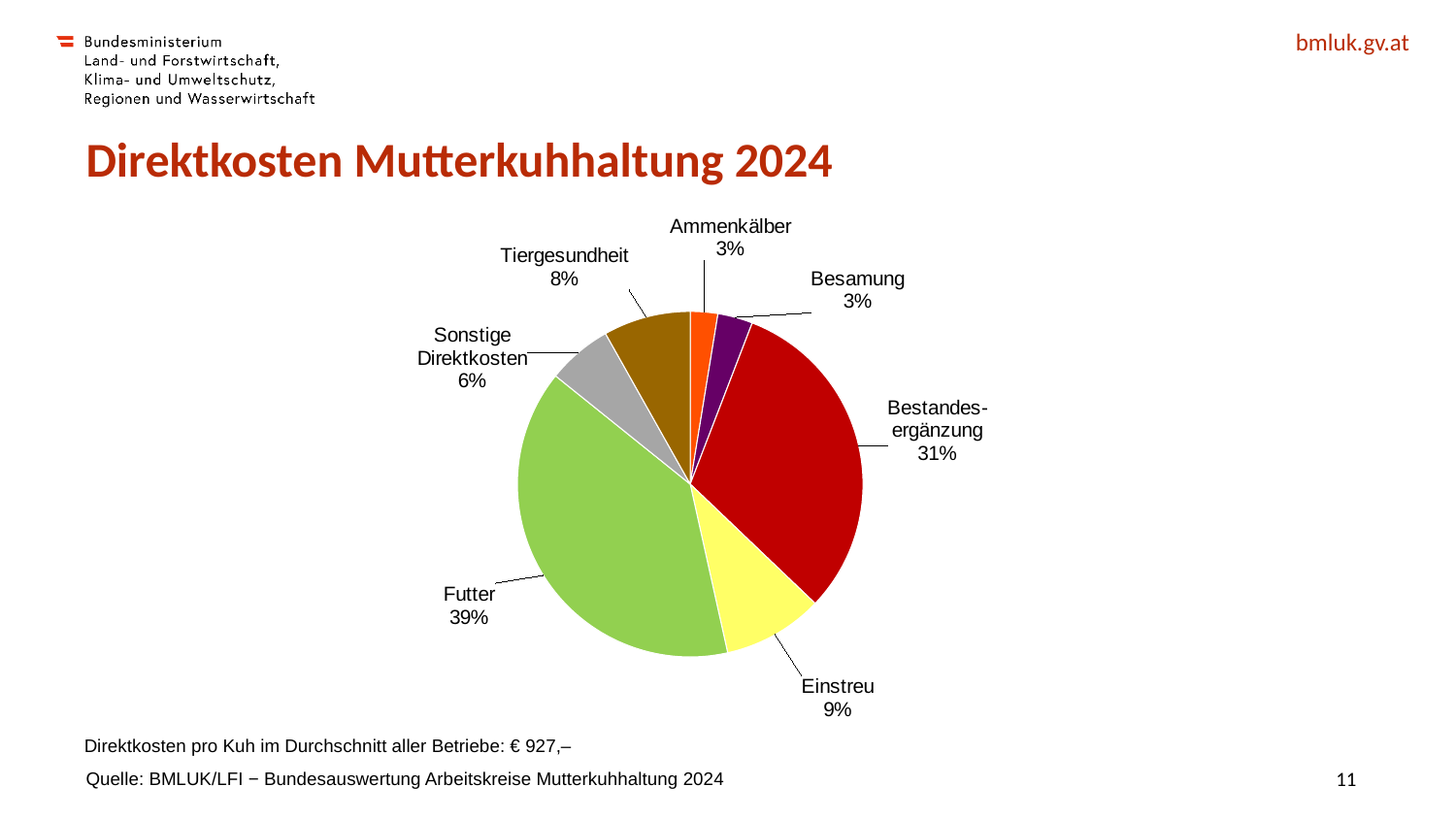
By how many percentage points does Futter exceed Bestandesergänzung? 8 percentage points What share of the pie does Futter account for? 39% What is the value shown for Sonstige Direktkosten? 6% What kind of chart is shown on the slide? Pie chart Which is larger, the share for Einstreu or the share for Tiergesundheit? Einstreu What share of the pie does Bestandesergänzung account for? 31% What is the combined share of Futter and Bestandesergänzung? 70% What is the value shown for Tiergesundheit? 8% Which category has the largest slice of the pie? Futter How many slices does the pie chart have? 7 What is the value shown for Einstreu? 9% What is the title of the chart? Direktkosten Mutterkuhhaltung 2024